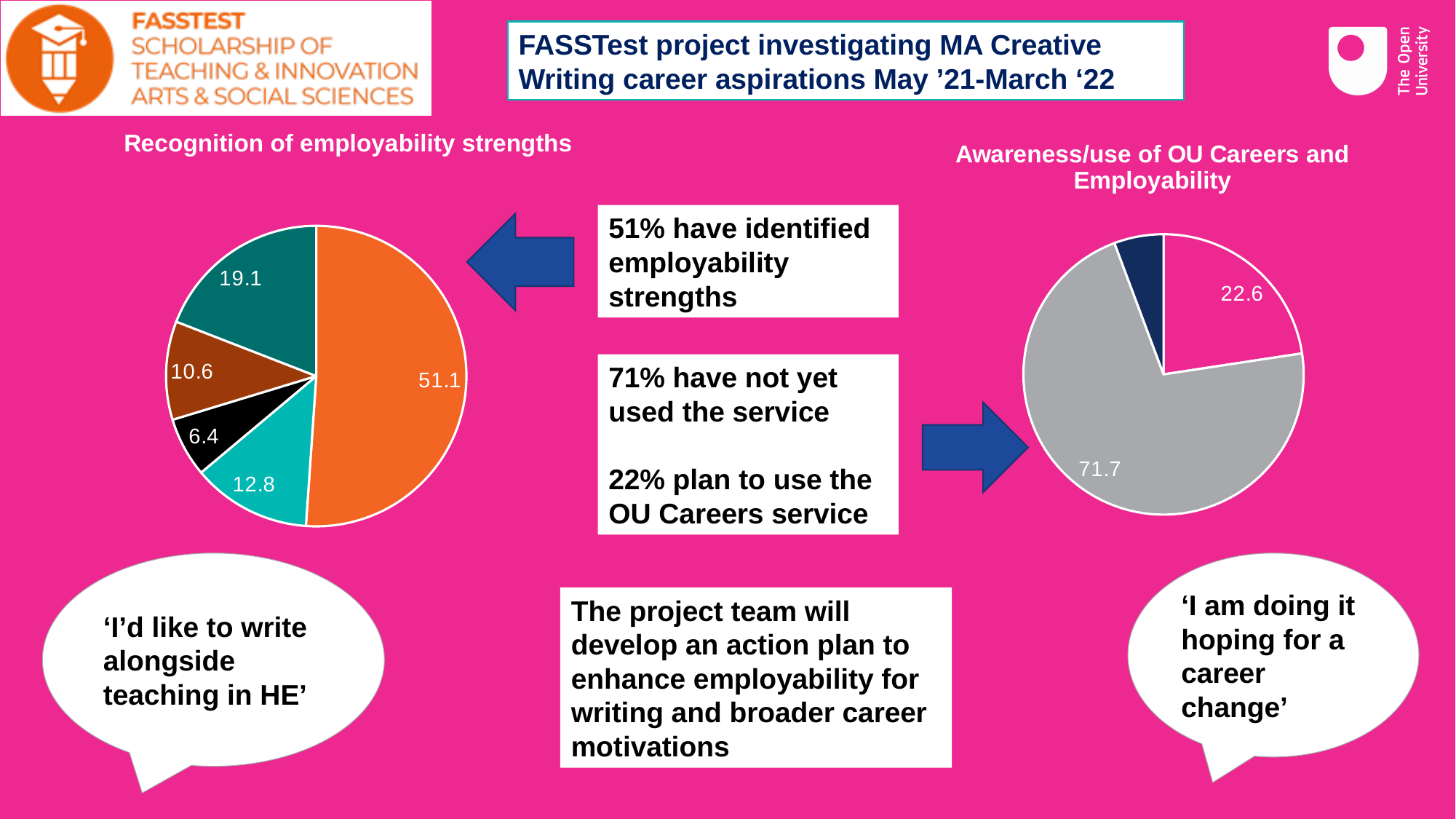
In the 'Recognition of employability strengths' chart, what is the value of the largest slice? 51.1 In the 'Recognition of employability strengths' chart, what is the difference between the slice labelled 51.1 and the slice labelled 19.1? 32.0 In the 'Awareness/use of OU Careers and Employability' chart, what is the value of the grey slice? 71.7 In the 'Awareness/use of OU Careers and Employability' chart, what is the difference between the slice labelled 71.7 and the slice labelled 22.6? 49.1 In the 'Recognition of employability strengths' chart, what is the value of the smallest slice? 6.4 How many slices does the 'Awareness/use of OU Careers and Employability' pie chart have? 3 What kind of chart is the 'Recognition of employability strengths' chart on the left? pie chart In the 'Awareness/use of OU Careers and Employability' chart, what is the value of the largest slice? 71.7 What kind of chart is the 'Awareness/use of OU Careers and Employability' chart on the right? pie chart What is the title of the pie chart on the left of the slide? Recognition of employability strengths How many slices does the 'Recognition of employability strengths' pie chart have? 5 In the 'Recognition of employability strengths' chart, which is larger, the orange slice or the dark teal slice? the orange slice